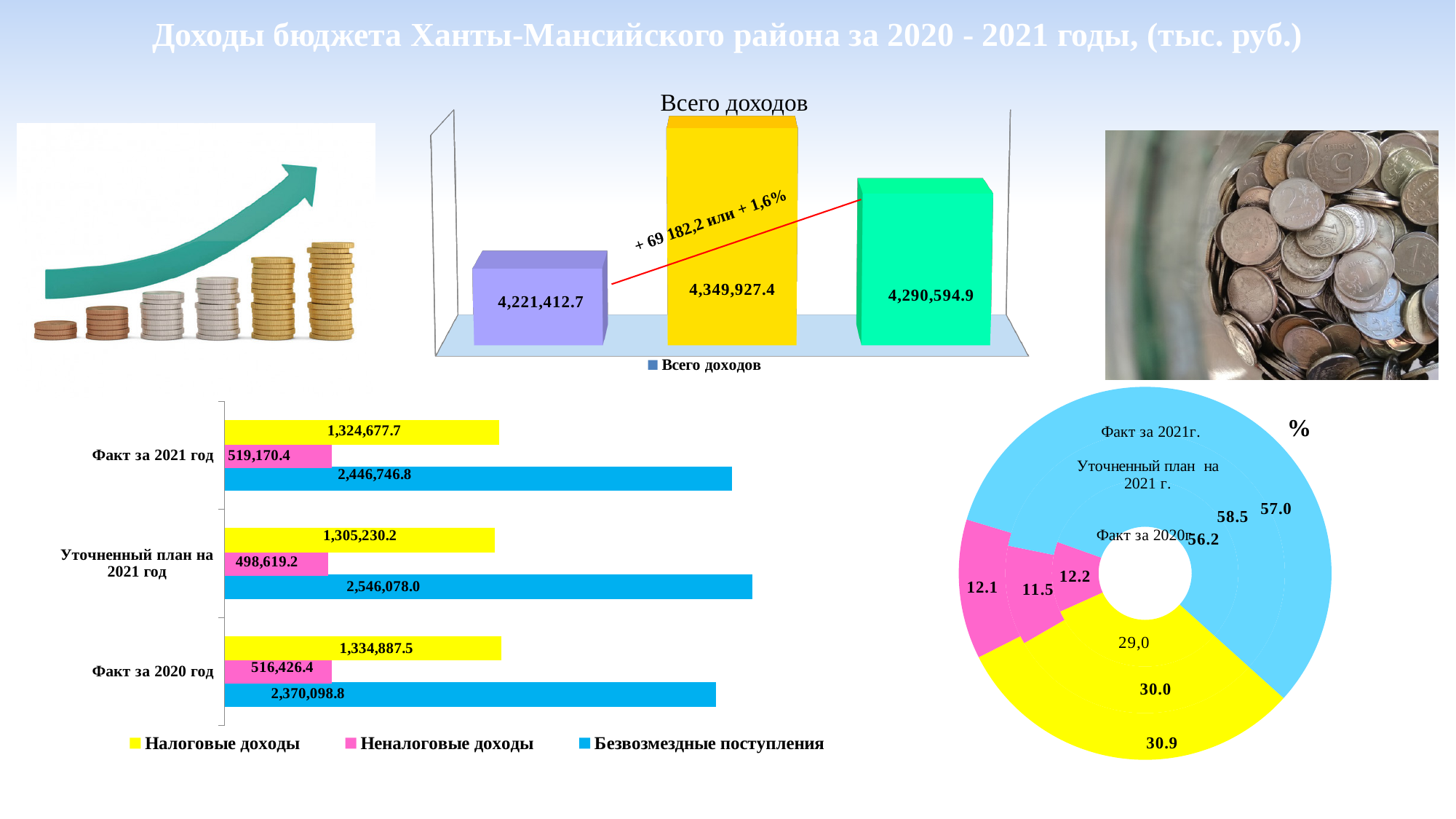
In the top chart titled 'Всего доходов', what is the lowest value shown? 4,221,412.7 In the bottom-left bar chart, what is the value of 'Налоговые доходы' for 'Уточненный план на 2021 год'? 1,305,230.2 In the bottom-right doughnut chart, what share does the blue segment of the outer ring ('Факт за 2021г.') show? 57.0 In the top chart titled 'Всего доходов', what is the highest value shown? 4,349,927.4 In the top chart titled 'Всего доходов', how many bars are plotted? 3 In the bottom-left bar chart, what is the difference between 'Неналоговые доходы' for 'Факт за 2021 год' and for 'Уточненный план на 2021 год'? 20,551.2 In the bottom-left bar chart, how many series does the legend list? 3 In the bottom-left bar chart, which series has the lowest value for 'Факт за 2021 год'? Неналоговые доходы In the bottom-left bar chart, what is the value of 'Неналоговые доходы' for 'Факт за 2020 год'? 516,426.4 In the bottom-left bar chart, which category has the highest value for 'Безвозмездные поступления'? Уточненный план на 2021 год What kind of chart is the bottom-left chart with the legend 'Налоговые доходы', 'Неналоговые доходы', 'Безвозмездные поступления'? bar chart In the bottom-left bar chart, what is the value of 'Безвозмездные поступления' for 'Факт за 2021 год'? 2,446,746.8